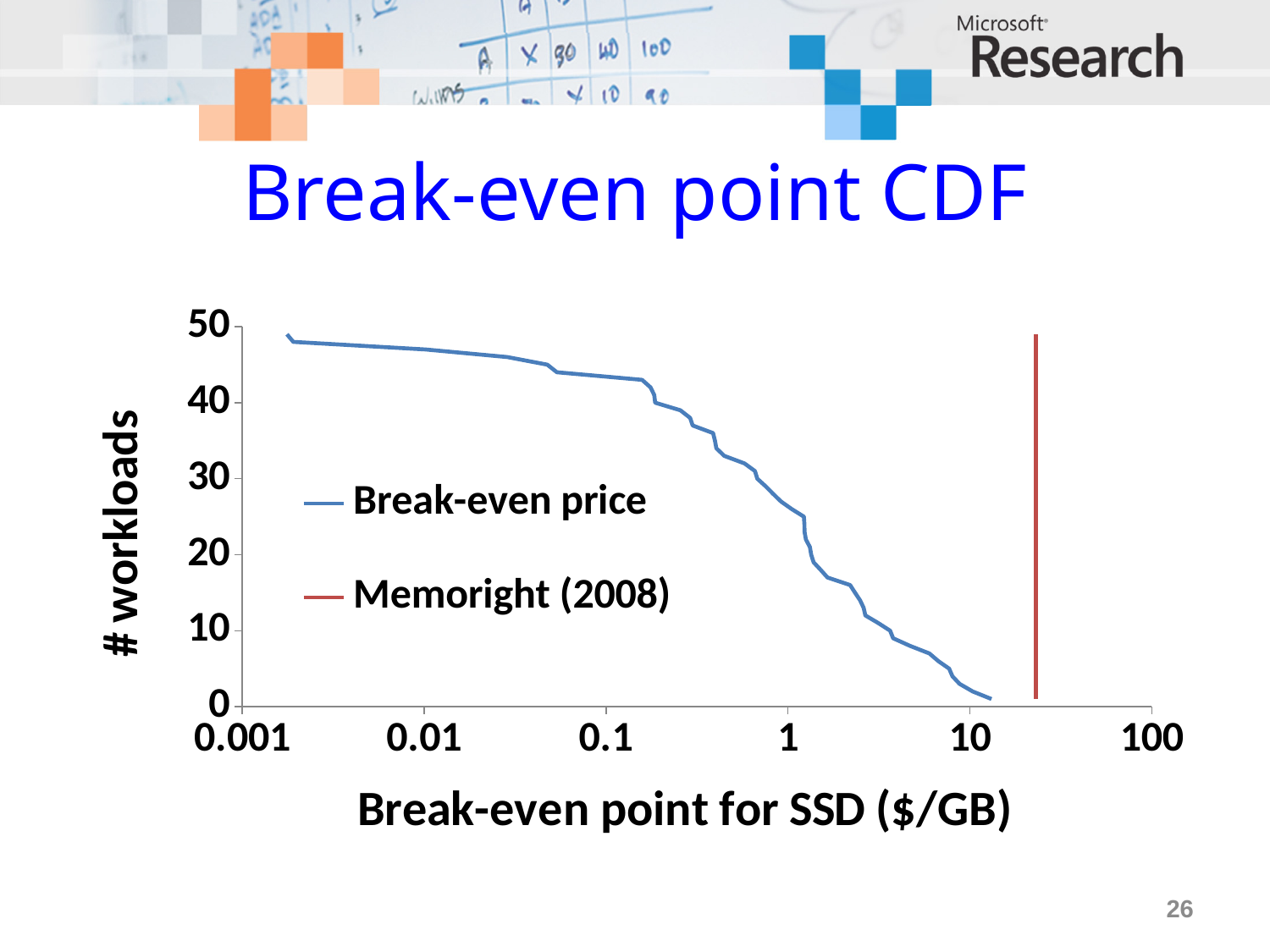
What kind of chart is shown on the slide? line chart Which series is drawn as a vertical line, Break-even price or Memoright (2008)? Memoright (2008) Is the Memoright (2008) price line positioned at a break-even point greater or less than 10 $/GB? greater Is the value of the Break-even price curve at 0.1 $/GB greater or less than 40 workloads? greater Does the number of workloads rise or fall as the break-even point increases along the x axis? fall Is the value of the Break-even price curve at 10 $/GB greater or less than 10 workloads? less How many series does the legend list? 2 What is the title of the chart? Break-even point CDF What is the label of the x axis? Break-even point for SSD ($/GB)